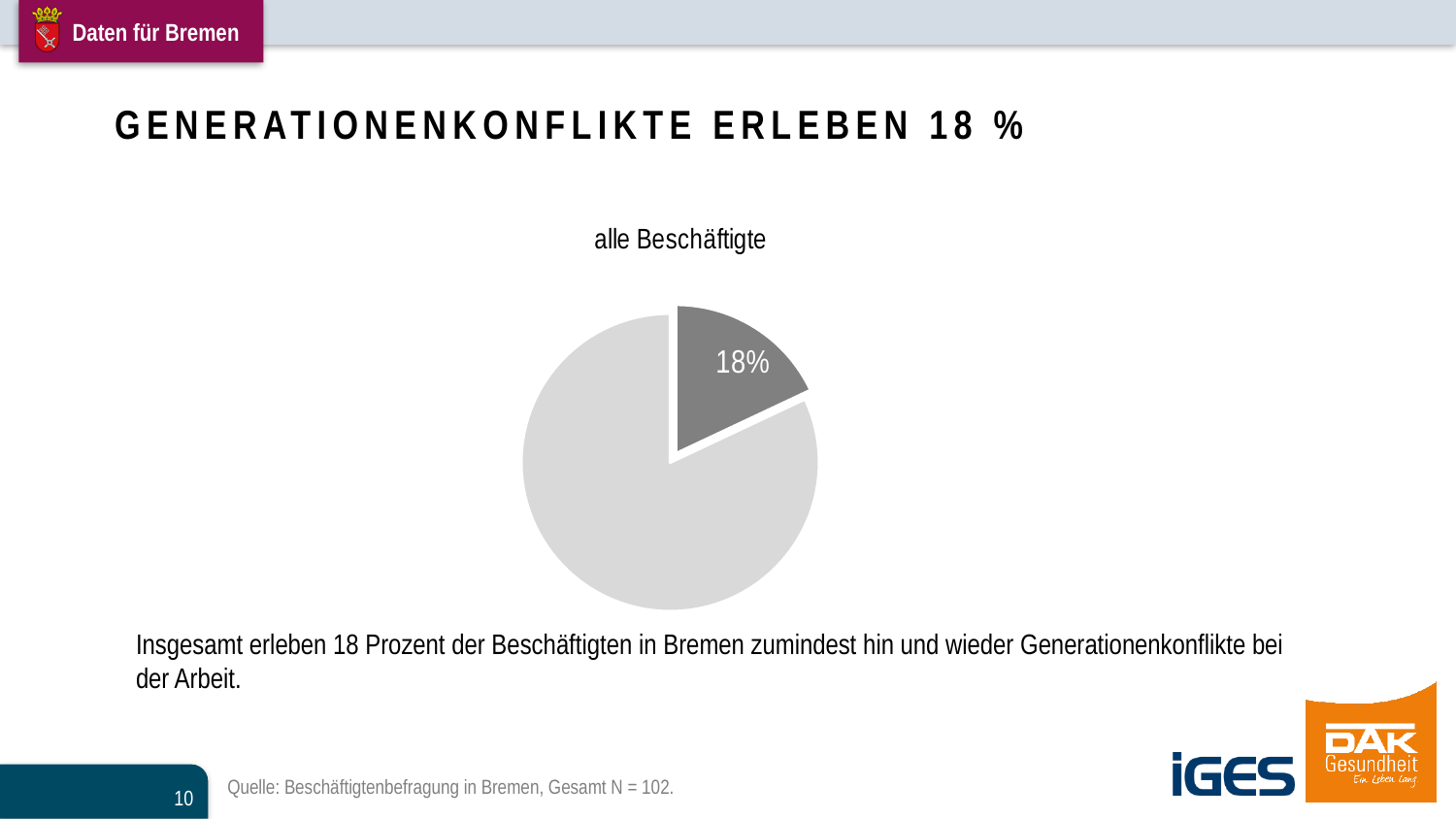
What percentage is printed on the labelled slice of the pie chart? 18% What share of the pie does the dark grey slice represent? 18% Which slice of the pie chart is larger, the dark grey slice or the light grey slice? the light grey slice What colour is the slice labelled 18%? dark grey How many slices does the pie chart have? 2 What kind of chart is shown on the slide? pie chart Which slice of the pie chart is the smallest? the dark grey slice (18%) What is the title of the chart on the slide? alle Beschäftigte